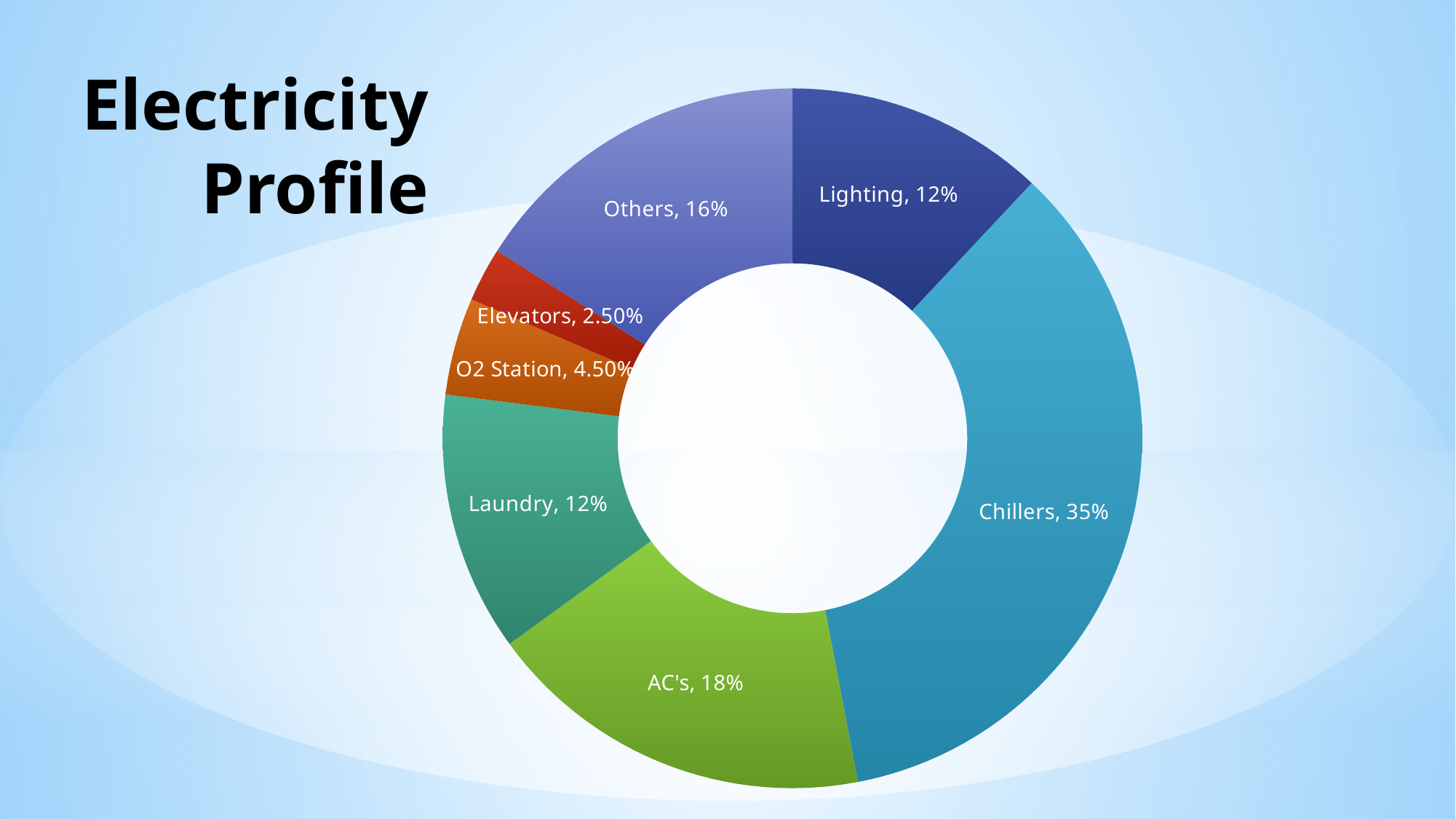
What is the value shown for Elevators? 2.50% What type of chart is shown on the slide? Doughnut (pie) chart Which category has the largest share of the chart? Chillers What percentage does the AC's slice represent? 18% What is the value shown for O2 Station? 4.50% What is the title of the slide? Electricity Profile What is the difference in percentage points between Chillers and AC's? 17% How many categories are shown in the chart? 7 Which is larger, the share for Others or the share for Laundry? Others What is the difference between the O2 Station and Elevators shares? 2.00% What share of electricity is used by Chillers? 35% Which category has the smallest share of the chart? Elevators